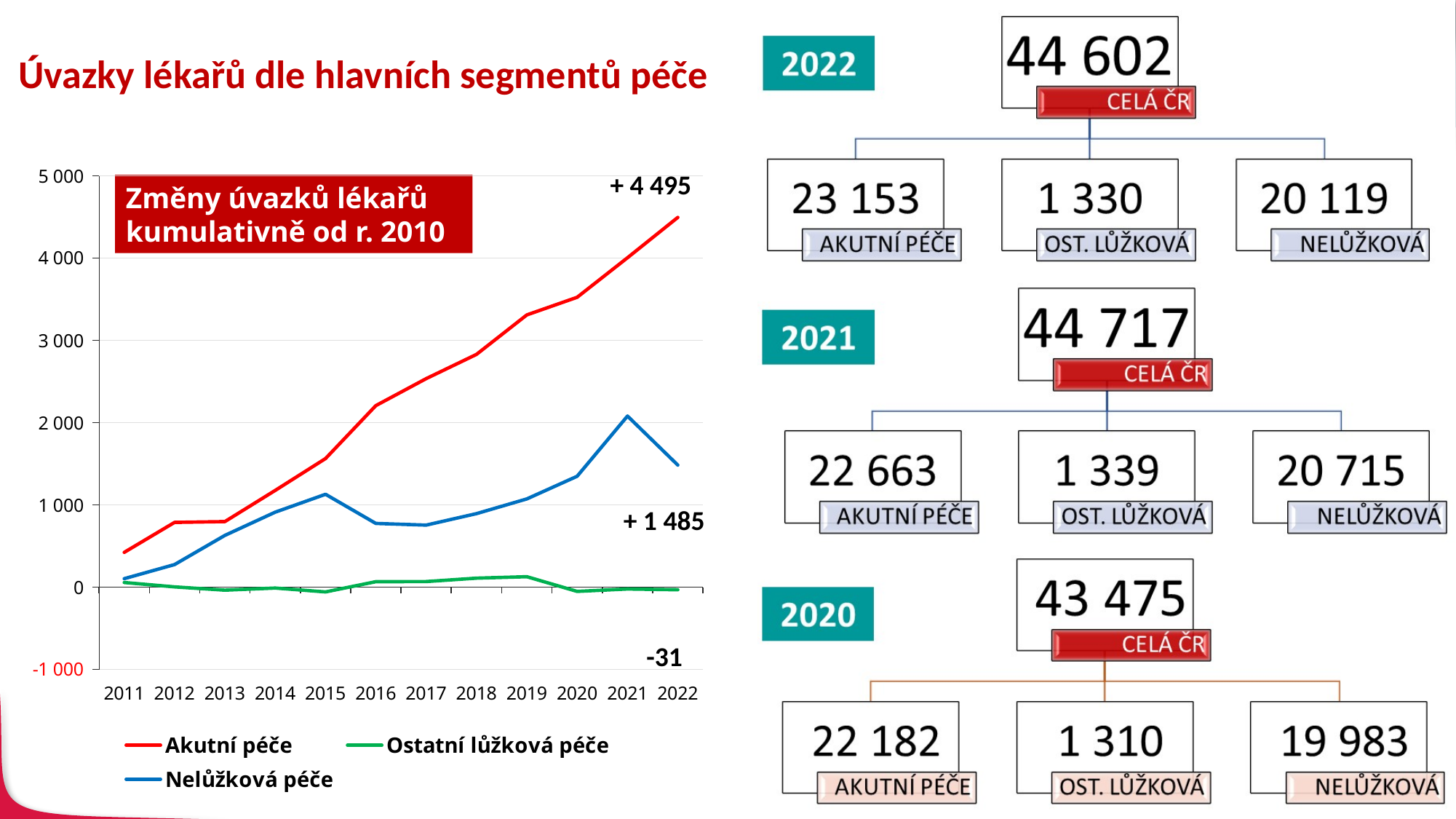
In the line chart, does the Akutní péče line rise or fall from 2011 to 2022? rises How many series does the legend of the line chart list? 3 What is the title shown inside the line chart? Změny úvazků lékařů kumulativně od r. 2010 In the line chart, is the value for Akutní péče in 2019 greater or less than 3 000? greater In the line chart, what is the labelled value for Ostatní lůžková péče in 2022? -31 In the line chart, what is the labelled value for Nelůžková péče in 2022? + 1 485 In the line chart, what is the difference between the 2022 values of Akutní péče and Nelůžková péče? 3 010 How many years are shown on the x axis of the line chart? 12 In the line chart, which series has the lowest value in 2022? Ostatní lůžková péče What type of chart is shown on the left of the slide? line chart In the line chart, which series has the highest value in 2022? Akutní péče In the line chart, what is the labelled value for Akutní péče in 2022? + 4 495